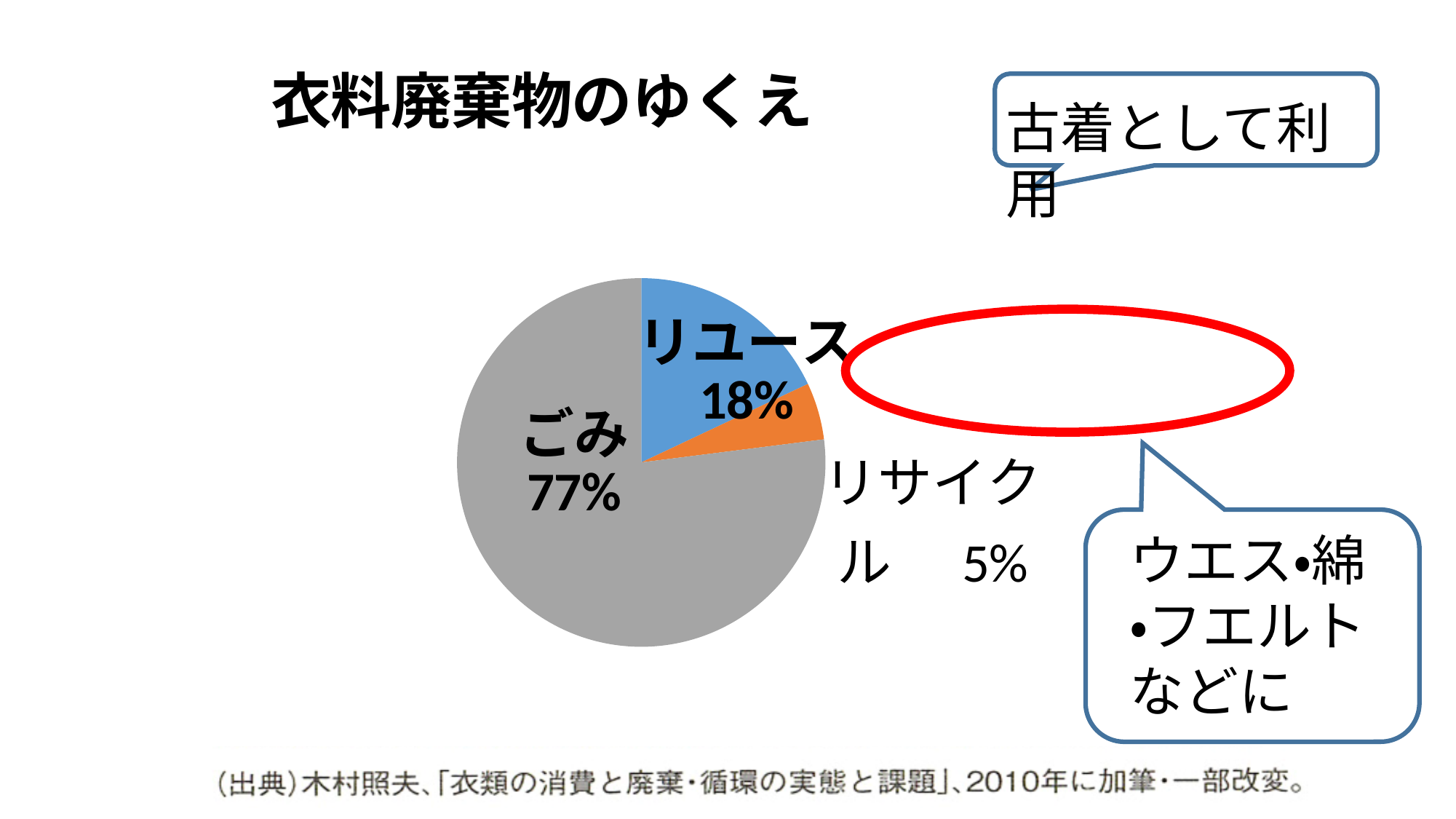
What percentage of the pie is リユース? 18% What kind of chart is shown on the slide? pie chart What percentage of the pie is ごみ? 77% What percentage of the pie is リサイクル? 5% What is the difference in percentage points between ごみ and リユース? 59 Which category has the largest share of the pie? ごみ Which category has the smallest share of the pie? リサイクル How many slices does the pie chart have? 3 What is the difference in percentage points between リユース and リサイクル? 13 Which is larger, the share for リユース or the share for リサイクル? リユース What colour is the ごみ slice of the pie? grey What is the title of the chart? 衣料廃棄物のゆくえ